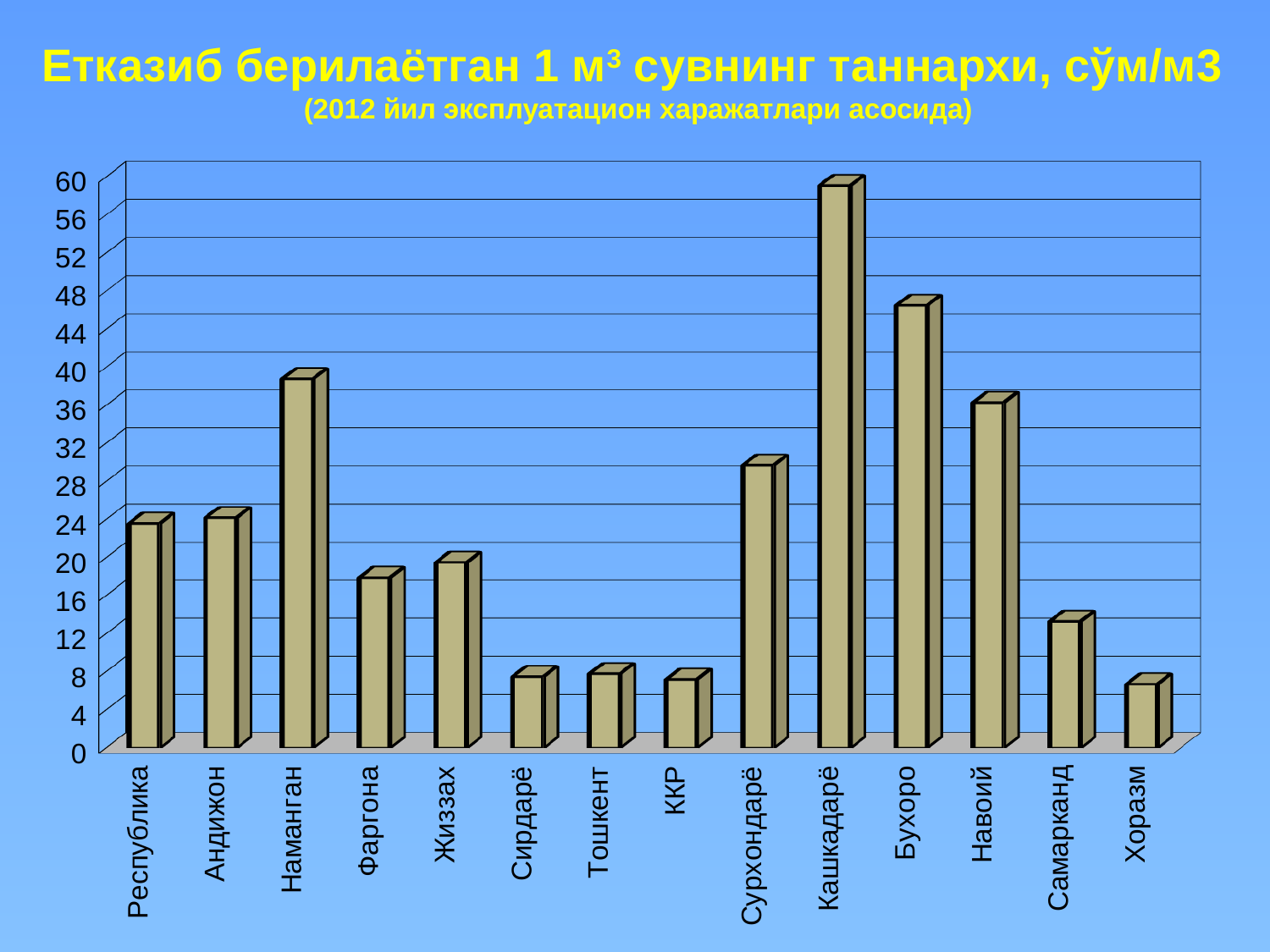
Is the value for Республика greater or less than 20? greater How many categories (regions) are shown on the x axis of the chart? 14 Is the value for Хоразм greater or less than 12? less Which is larger, the value for Наманган or the value for Бухоро? Бухоро What kind of chart is shown on the slide? bar chart Is the value for Самарканд greater or less than 16? less Which is larger, the value for Сурхондарё or the value for Навоий? Навоий Which year do the operating costs in the chart's subtitle refer to? 2012 Which category has the highest value in the chart? Кашкадарё